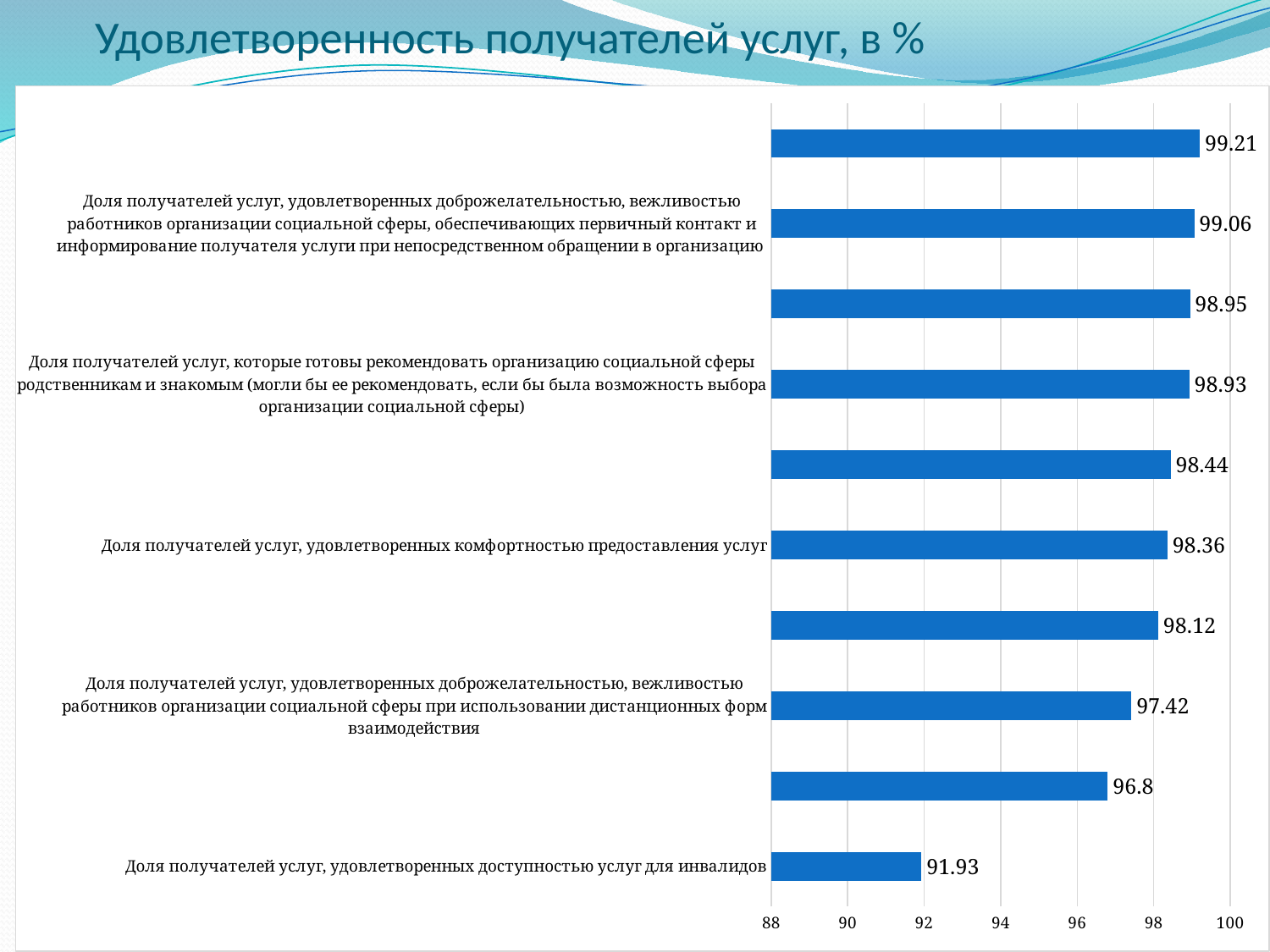
What is the value for 'Доля получателей услуг, удовлетворенных комфортностью предоставления услуг'? 98.36 What is the value for the share of recipients satisfied with the friendliness and politeness of staff providing first contact and information on direct contact with the organization? 99.06 How many bars are plotted on the chart? 10 What is the highest value shown on the chart? 99.21 Which category has the lowest value on the chart? Доля получателей услуг, удовлетворенных доступностью услуг для инвалидов What is the difference between the value for satisfaction with comfort of service provision (98.36) and the value for satisfaction with accessibility of services for disabled people (91.93)? 6.43 Is the value for 'Доля получателей услуг, удовлетворенных доступностью услуг для инвалидов' greater or less than 94? less What type of chart is shown on the slide? Bar chart What is the value for 'Доля получателей услуг, удовлетворенных доступностью услуг для инвалидов'? 91.93 What is the value for the share of recipients satisfied with the friendliness and politeness of staff when using remote forms of interaction ('при использовании дистанционных форм взаимодействия')? 97.42 Which is larger: the value for readiness to recommend the organization or the value for satisfaction with staff politeness when using remote forms of interaction? Readiness to recommend the organization (98.93) What is the value for the share of recipients who are ready to recommend the organization to relatives and acquaintances? 98.93